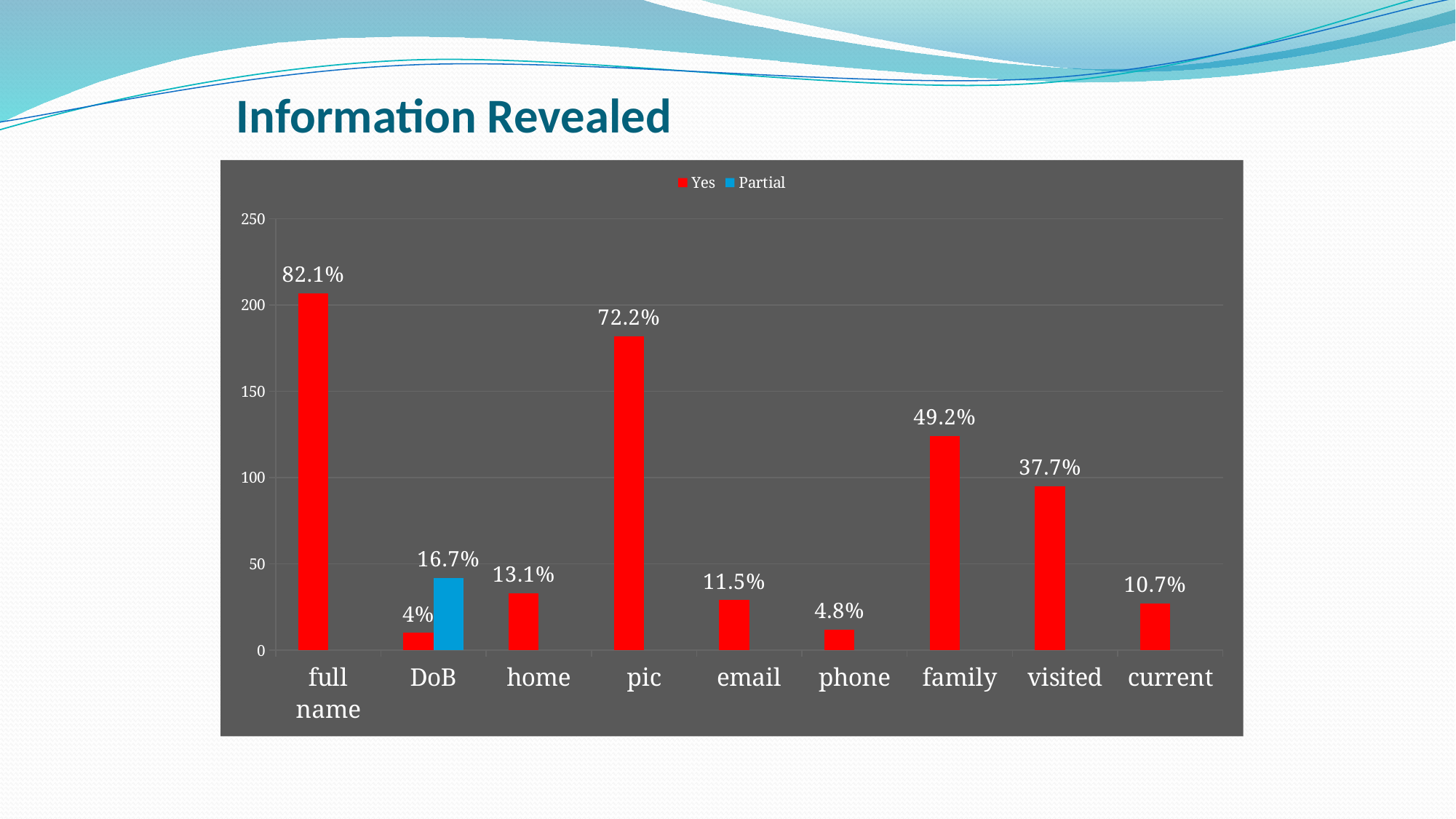
Is the 'Yes' bar for visited greater or less than 100 on the axis? less Which is larger, the 'Yes' bar for visited or the 'Yes' bar for family? family Which category has the highest 'Yes' bar? full name How many series does the legend list? 2 How many categories are shown on the x axis? 9 Which category has the lowest 'Yes' bar? DoB What is the data label on the 'Partial' bar for DoB? 16.7% Is the 'Yes' bar for full name greater or less than 200 on the axis? greater What is the data label on the 'Yes' bar for full name? 82.1% What is the title of the slide containing the chart? Information Revealed What kind of chart is shown on the slide? bar chart What is the data label on the 'Yes' bar for family? 49.2%